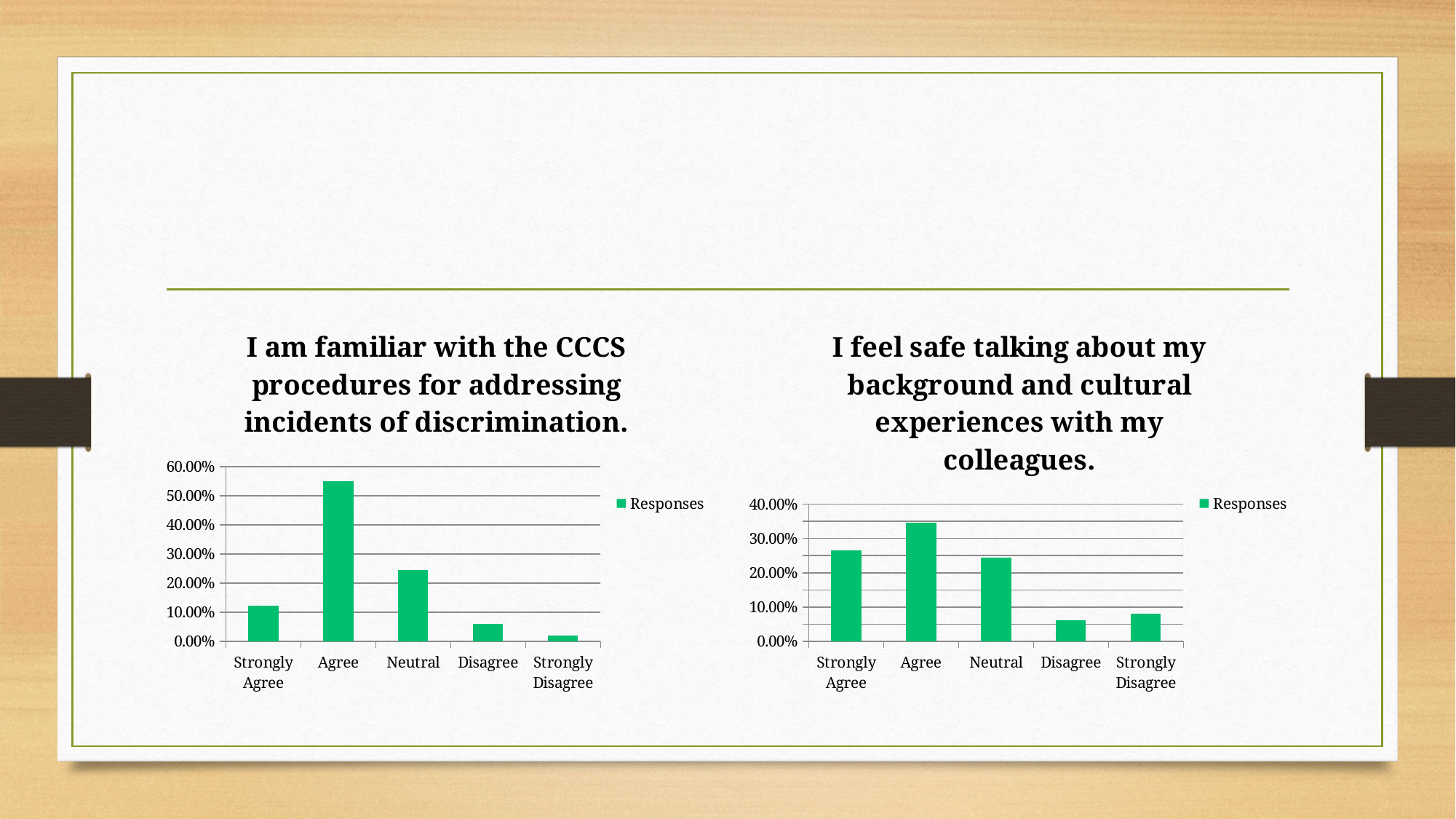
In the chart titled "I feel safe talking about my background and cultural experiences with my colleagues.", which category has the lowest value? Disagree How many series does the legend list in the chart titled "I am familiar with the CCCS procedures for addressing incidents of discrimination."? 1 In the chart titled "I am familiar with the CCCS procedures for addressing incidents of discrimination.", which category has the lowest value? Strongly Disagree In the chart titled "I am familiar with the CCCS procedures for addressing incidents of discrimination.", which category has the highest value? Agree In the chart titled "I feel safe talking about my background and cultural experiences with my colleagues.", which is larger, the value for Strongly Agree or the value for Strongly Disagree? Strongly Agree How many categories are shown on the x axis of the chart titled "I feel safe talking about my background and cultural experiences with my colleagues."? 5 What kind of chart is the chart titled "I feel safe talking about my background and cultural experiences with my colleagues."? Bar chart In the chart titled "I am familiar with the CCCS procedures for addressing incidents of discrimination.", is the value for Agree greater or less than 50.00%? greater In the chart titled "I feel safe talking about my background and cultural experiences with my colleagues.", which category has the highest value? Agree In the chart titled "I am familiar with the CCCS procedures for addressing incidents of discrimination.", which is larger, the value for Neutral or the value for Strongly Agree? Neutral In the chart titled "I am familiar with the CCCS procedures for addressing incidents of discrimination.", is the value for Strongly Agree greater or less than 20.00%? less In the chart titled "I feel safe talking about my background and cultural experiences with my colleagues.", is the value for Agree greater or less than 30.00%? greater